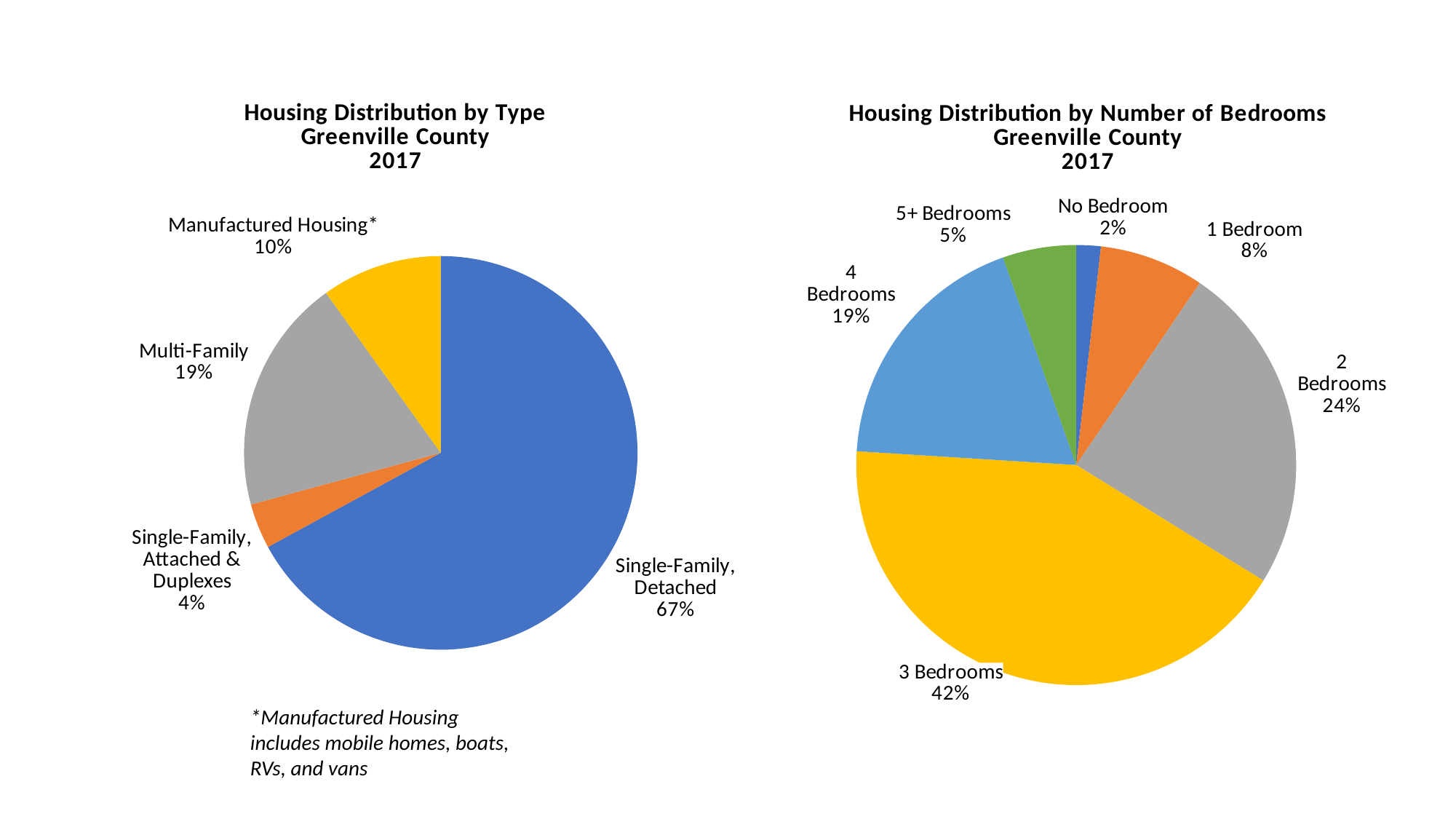
In the 'Housing Distribution by Number of Bedrooms' chart, which is larger: the share for 2 Bedrooms or the share for 4 Bedrooms? 2 Bedrooms In the 'Housing Distribution by Type' chart, which category has the smallest share? Single-Family, Attached & Duplexes In the 'Housing Distribution by Type' chart, what is the difference between the Multi-Family share and the Manufactured Housing share? 9% In the 'Housing Distribution by Number of Bedrooms' chart, how many categories are shown? 6 In the 'Housing Distribution by Type' chart, what share of housing is Manufactured Housing? 10% In the 'Housing Distribution by Number of Bedrooms' chart, which category has the largest share? 3 Bedrooms In the 'Housing Distribution by Number of Bedrooms' chart, what share of housing has No Bedroom? 2% In the 'Housing Distribution by Number of Bedrooms' chart, what share of housing has 3 Bedrooms? 42% What kind of chart is 'Housing Distribution by Type'? Pie chart In the 'Housing Distribution by Type' chart, how many categories are shown? 4 In the 'Housing Distribution by Type' chart, what share of housing is Single-Family, Detached? 67% According to the footnote on the 'Housing Distribution by Type' chart, what does Manufactured Housing include? Mobile homes, boats, RVs, and vans